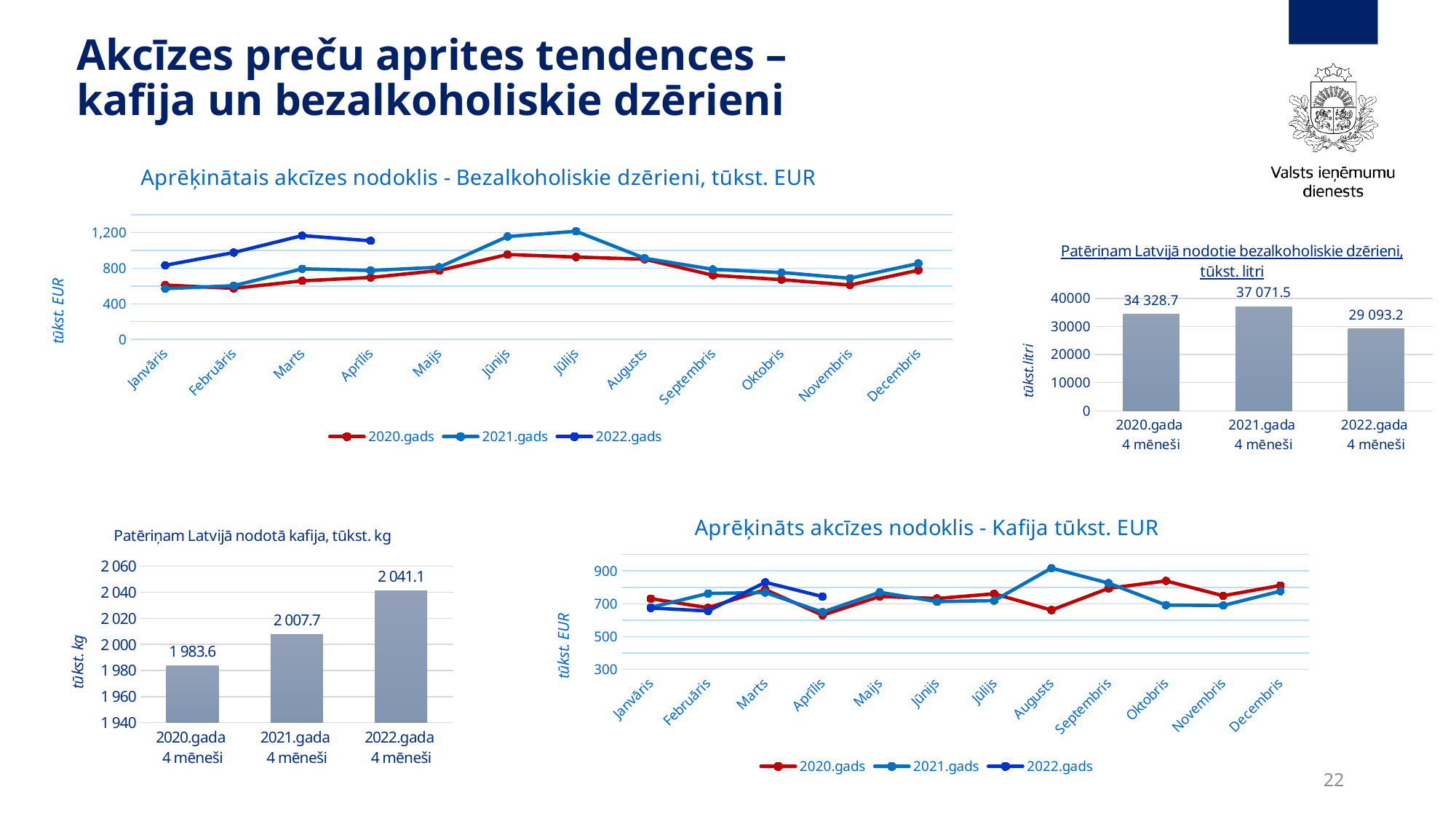
In the chart 'Aprēķināts akcīzes nodoklis - Kafija tūkst. EUR', is the value for 2020.gads in Aprīlis greater or less than 700? less In the chart 'Aprēķinātais akcīzes nodoklis - Bezalkoholiskie dzērieni, tūkst. EUR', how many months are shown on the x axis? 12 In the chart 'Patēriņam Latvijā nodotie bezalkoholiskie dzērieni, tūkst. litri', what is the difference between the 2021.gada 4 mēneši and 2020.gada 4 mēneši values? 2 742.8 In the chart 'Aprēķinātais akcīzes nodoklis - Bezalkoholiskie dzērieni, tūkst. EUR', is the value for 2022.gads in Marts greater or less than 800? greater What kind of chart is 'Patēriņam Latvijā nodotā kafija, tūkst. kg'? bar chart In the chart 'Patēriņam Latvijā nodotā kafija, tūkst. kg', which period has the highest value? 2022.gada 4 mēneši In the chart 'Patēriņam Latvijā nodotie bezalkoholiskie dzērieni, tūkst. litri', what is the value for 2021.gada 4 mēneši? 37 071.5 In the chart 'Patēriņam Latvijā nodotā kafija, tūkst. kg', what is the difference between the 2022.gada 4 mēneši and 2020.gada 4 mēneši values? 57.5 In the chart 'Patēriņam Latvijā nodotā kafija, tūkst. kg', do the values rise or fall from 2020.gada 4 mēneši to 2022.gada 4 mēneši? rise In the chart 'Patēriņam Latvijā nodotie bezalkoholiskie dzērieni, tūkst. litri', which period has the lowest value? 2022.gada 4 mēneši In the chart 'Aprēķinātais akcīzes nodoklis - Bezalkoholiskie dzērieni, tūkst. EUR', how many series does the legend list? 3 In the chart 'Patēriņam Latvijā nodotā kafija, tūkst. kg', what is the value for 2022.gada 4 mēneši? 2 041.1